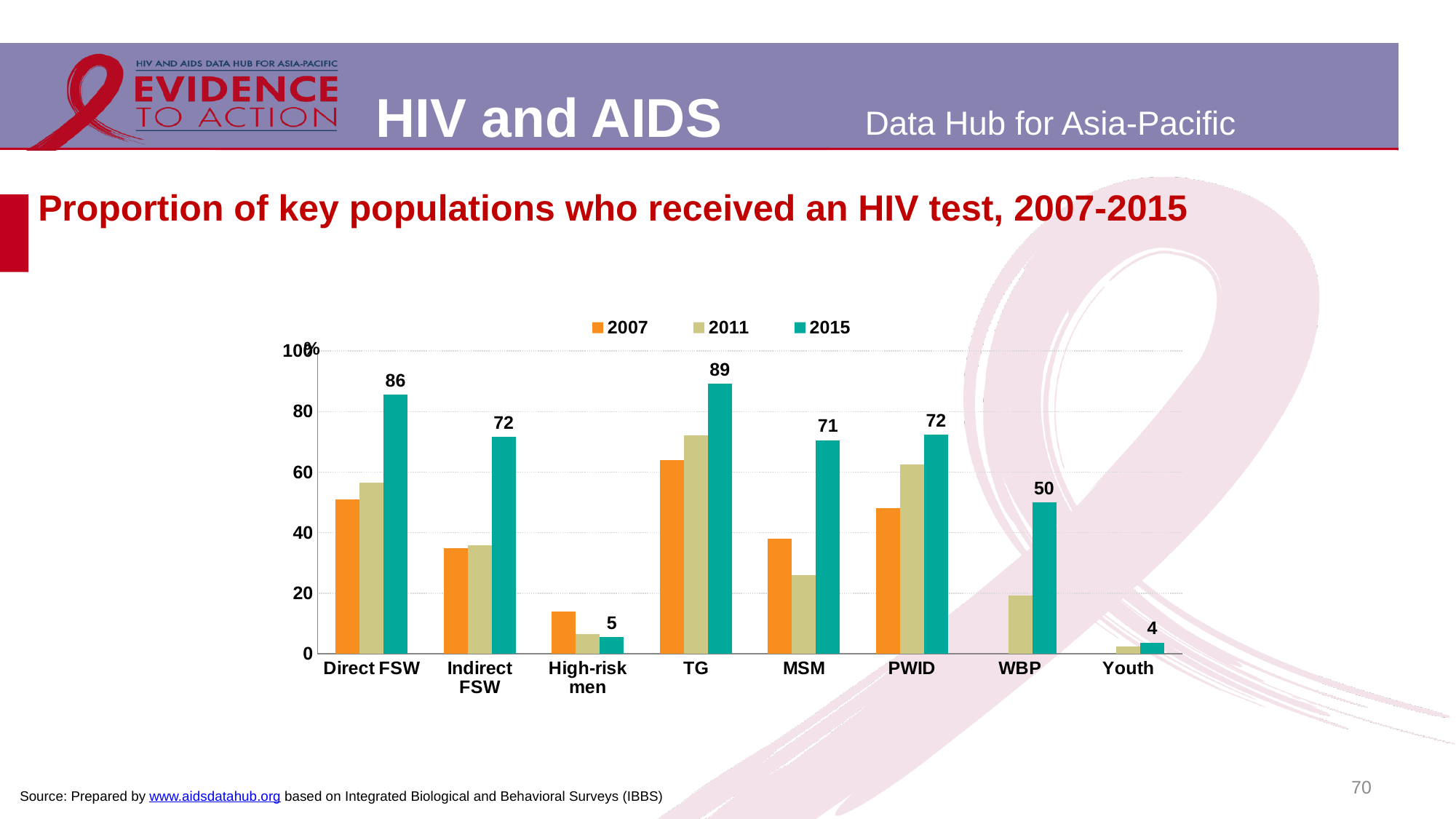
Which key population has the lowest 2015 value? Youth How many series does the legend list? 3 Is the 2011 value for MSM greater or less than 40? less What is the 2015 value for Youth? 4 What is the 2015 value for Direct FSW? 86 Which is larger, the 2015 value for Direct FSW or the 2015 value for PWID? Direct FSW What is the 2015 value for WBP? 50 Which key population has the highest 2015 value? TG What is the 2015 value for TG? 89 Is the 2007 value for Direct FSW greater or less than 40? greater What is the difference between the 2015 values for TG and Direct FSW? 3 How many key population categories are shown on the x axis? 8